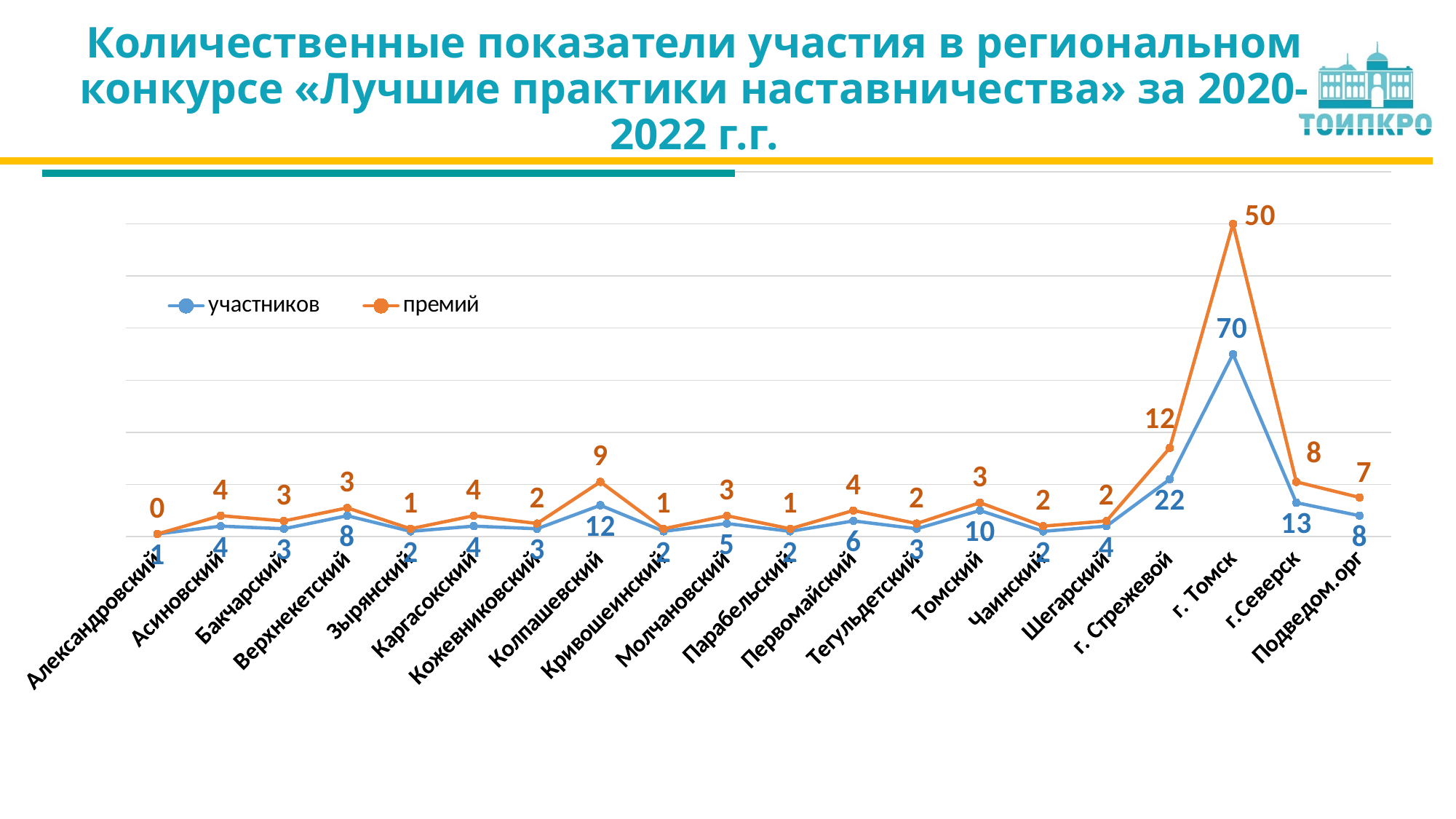
Which is larger, участников for г.Северск or участников for Томский? г.Северск What are the two series names listed in the legend? участников, премий What is the value of премий for г. Стрежевой? 12 How many categories are shown on the x axis? 20 What is the value of участников for г. Томск? 70 What is the value of премий for Александровский? 0 Which category has the highest value of премий? г. Томск How many series does the legend list? 2 What is the value of участников for Колпашевский? 12 Which category has the lowest value of премий? Александровский What type of chart is shown on the slide? line chart What is the difference between участников and премий for г. Томск? 20